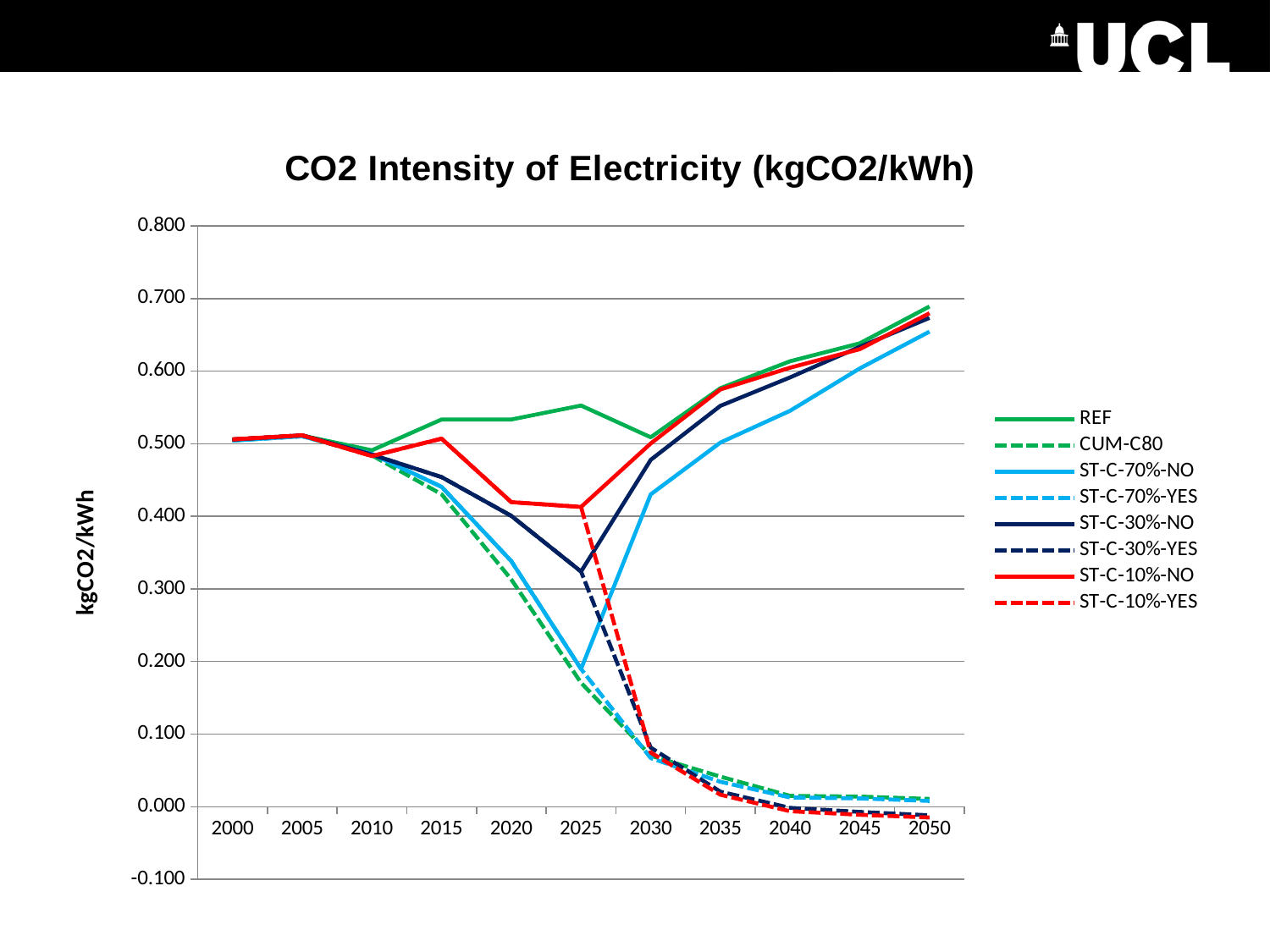
What is the title of the chart? CO2 Intensity of Electricity (kgCO2/kWh) Is the value for REF in 2050 greater or less than 0.600? greater Is the value for ST-C-70%-NO in 2025 greater or less than 0.300? less In 2025, which is higher: ST-C-10%-NO or ST-C-30%-NO? ST-C-10%-NO What kind of chart is shown on the slide? line chart How many series does the legend list? 8 What is the label on the vertical axis? kgCO2/kWh Which series has the highest value in 2025? REF Which series has the highest value in 2050? REF Does the REF series rise or fall between 2030 and 2050? rise Is the value for CUM-C80 in 2050 greater or less than 0.100? less How many years are marked along the x axis? 11